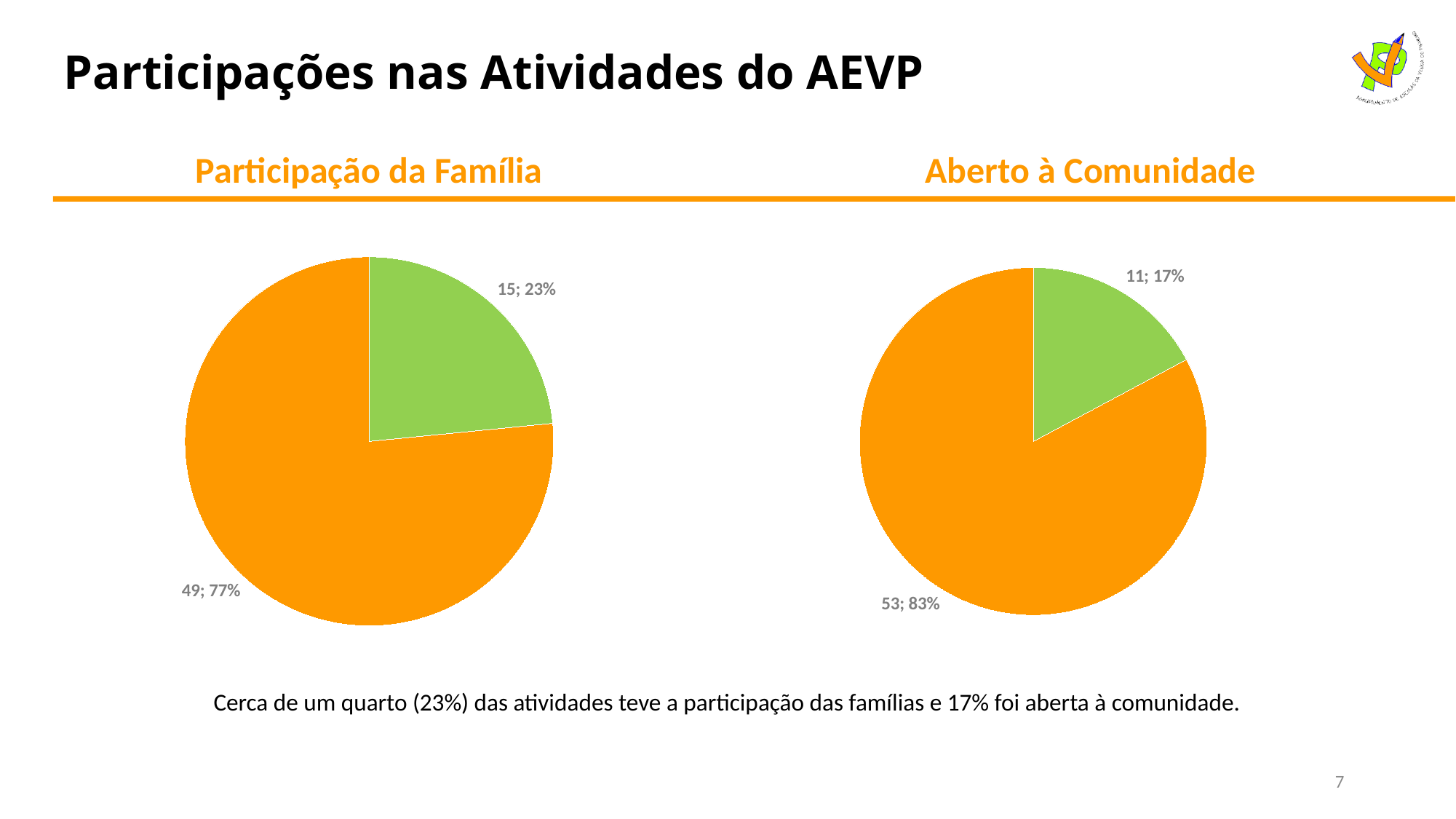
In the 'Aberto à Comunidade' pie chart, what label is shown on the orange slice? 53; 83% In the 'Aberto à Comunidade' pie chart, which slice is the smallest? the green slice (11; 17%) What is the total count represented by the 'Aberto à Comunidade' pie chart? 64 In the 'Participação da Família' pie chart, what label is shown on the green slice? 15; 23% What kind of chart is used under 'Participação da Família'? pie chart How many slices does the 'Aberto à Comunidade' pie chart have? 2 In the 'Participação da Família' pie chart, which slice is larger, the orange or the green? orange In the 'Participação da Família' pie chart, what share of the pie does the green slice represent? 23% In the 'Aberto à Comunidade' pie chart, what label is shown on the green slice? 11; 17% In the 'Aberto à Comunidade' pie chart, what share of the pie does the orange slice represent? 83% In the 'Participação da Família' pie chart, what is the difference between the counts of the orange and green slices? 34 In the 'Participação da Família' pie chart, what label is shown on the orange slice? 49; 77%